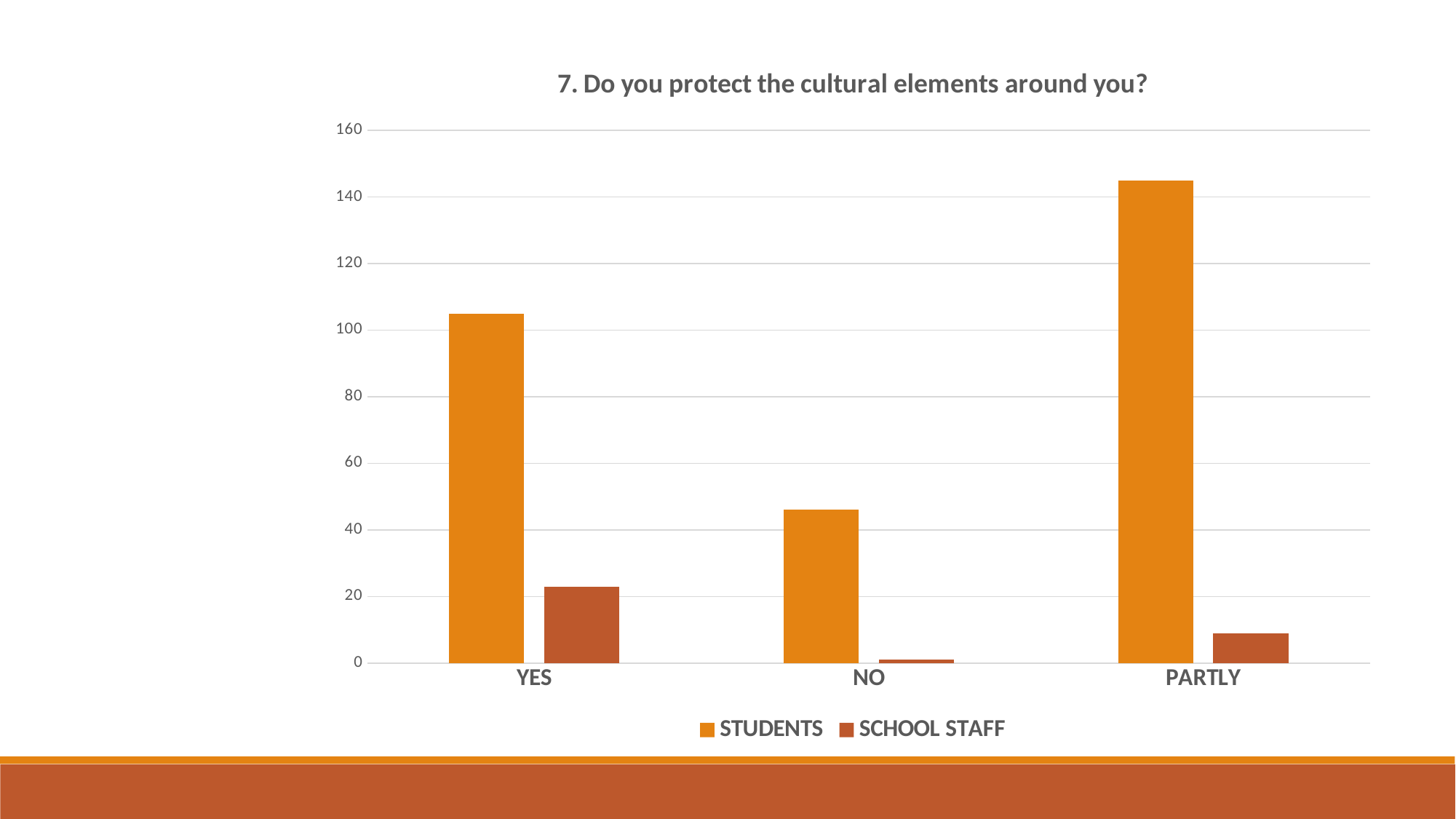
Is the STUDENTS value for NO greater or less than 60? less Which category has the highest value for STUDENTS? PARTLY What kind of chart is shown on the slide? bar chart Which category has the highest value for SCHOOL STAFF? YES How many series does the legend list? 2 Which category has the lowest value for SCHOOL STAFF? NO Which category has the lowest value for STUDENTS? NO Which is larger, the STUDENTS value for YES or the STUDENTS value for NO? YES Is the SCHOOL STAFF value for YES greater or less than 20? greater Is the STUDENTS value for PARTLY greater or less than 140? greater How many categories are shown on the x axis? 3 What is the title of the chart? 7. Do you protect the cultural elements around you?